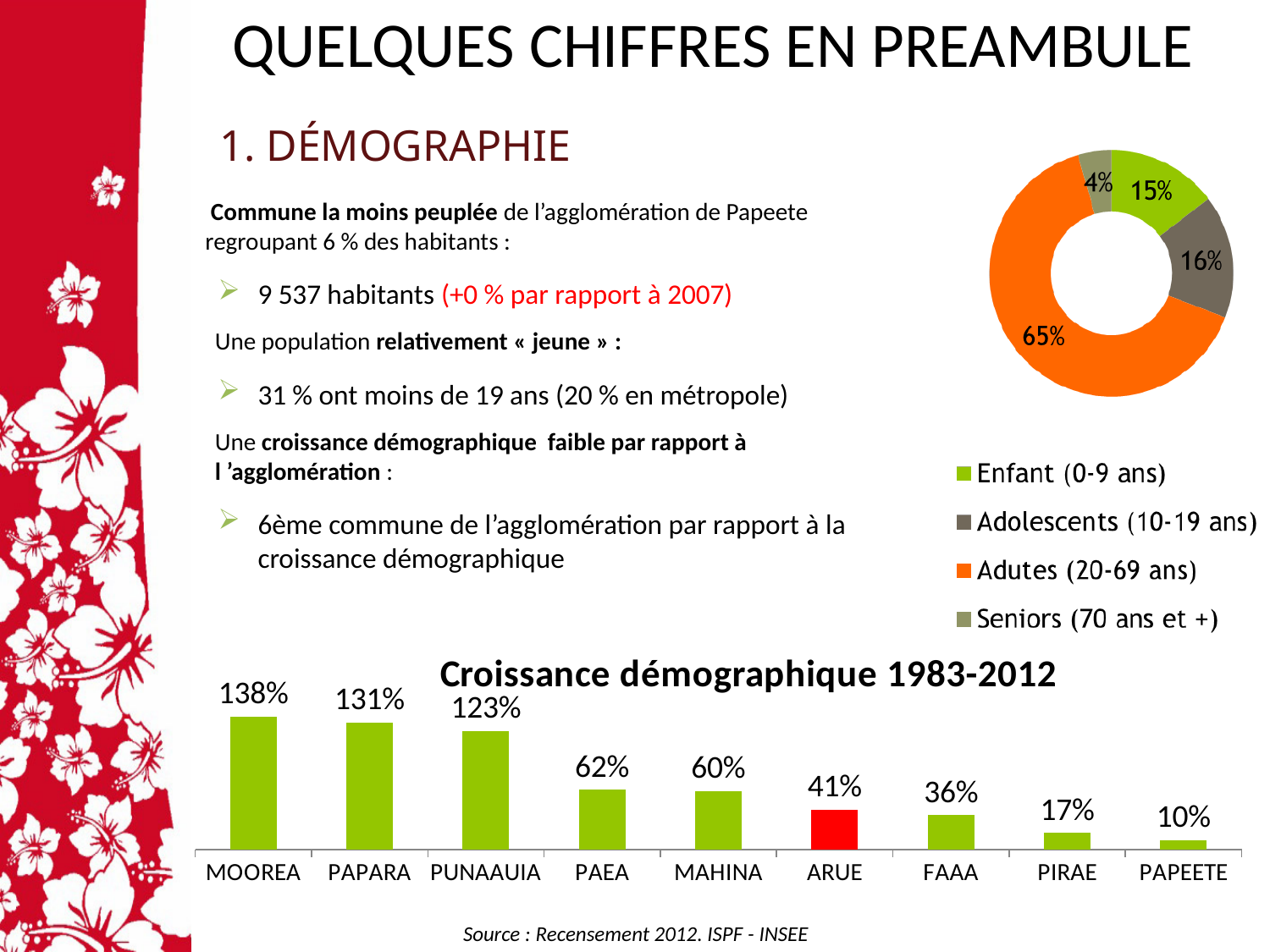
In the bar chart 'Croissance démographique 1983-2012', what is the difference between the values for PAPARA and PAEA? 69% In the bar chart 'Croissance démographique 1983-2012', what is the value for ARUE? 41% In the doughnut chart at the top right, what share is shown for Adultes (20-69 ans)? 65% In the bar chart 'Croissance démographique 1983-2012', which commune has the highest value? MOOREA In the bar chart 'Croissance démographique 1983-2012', which is larger, the value for FAAA or the value for PIRAE? FAAA In the bar chart 'Croissance démographique 1983-2012', which bar is coloured red instead of green? ARUE In the bar chart 'Croissance démographique 1983-2012', do the values rise or fall from left to right? fall How many communes are shown in the bar chart 'Croissance démographique 1983-2012'? 9 In the bar chart 'Croissance démographique 1983-2012', which commune has the lowest value? PAPEETE In the bar chart 'Croissance démographique 1983-2012', what is the value for MOOREA? 138% In the doughnut chart at the top right, which age group has the smallest share? Seniors (70 ans et +) How many entries does the legend of the doughnut chart at the top right list? 4